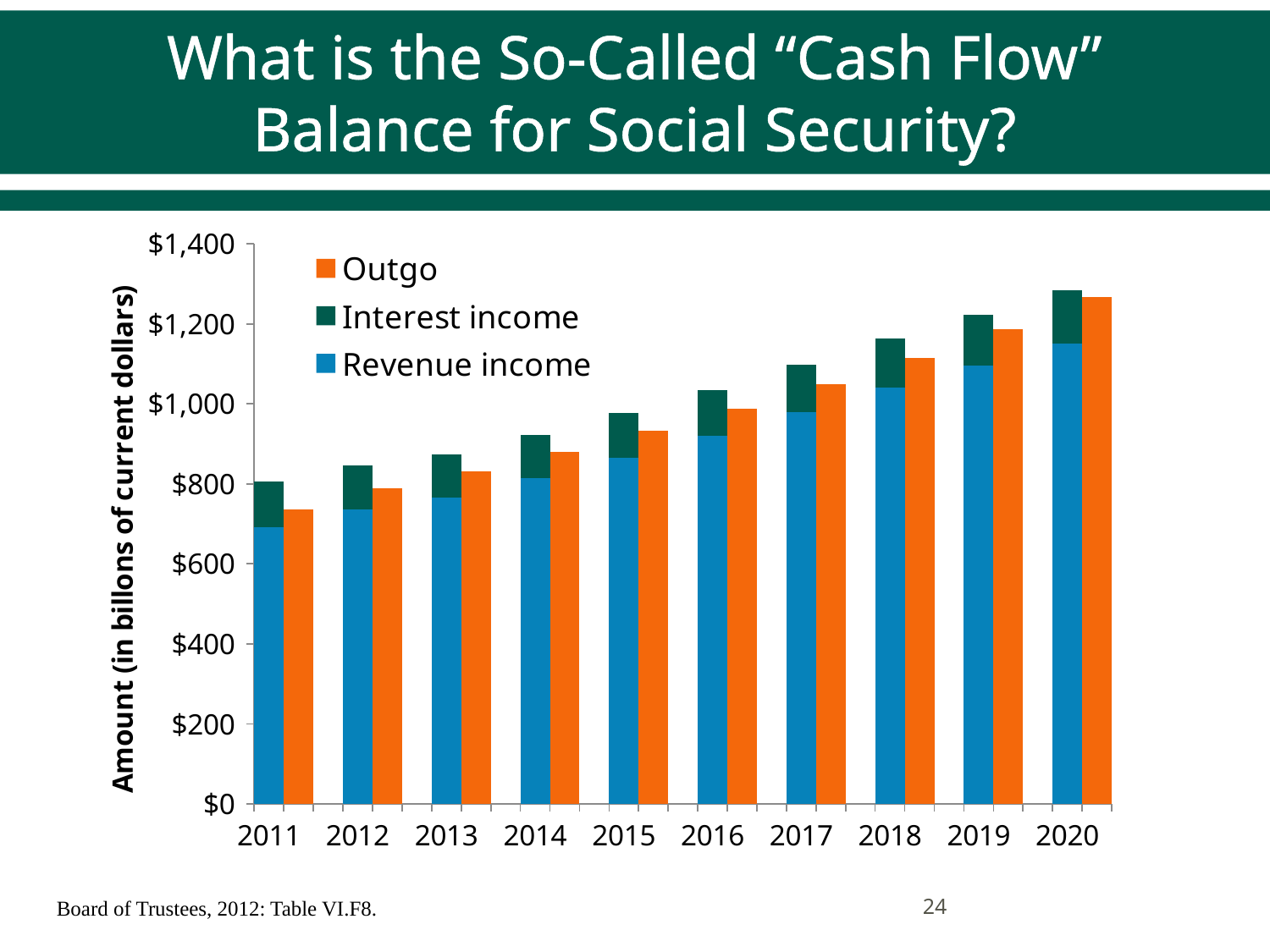
In which year is Revenue income lowest? 2011 How many series does the legend list? 3 What kind of chart is shown on the slide? bar chart How many years are shown on the x axis? 10 Which colour represents Outgo in the legend? orange Is the Outgo value for 2011 greater or less than $800? less Is the Revenue income value for 2011 greater or less than $800? less Do the Outgo values rise or fall from 2011 to 2020? rise Is the Outgo value for 2015 greater or less than $1,000? less In which year is Outgo highest? 2020